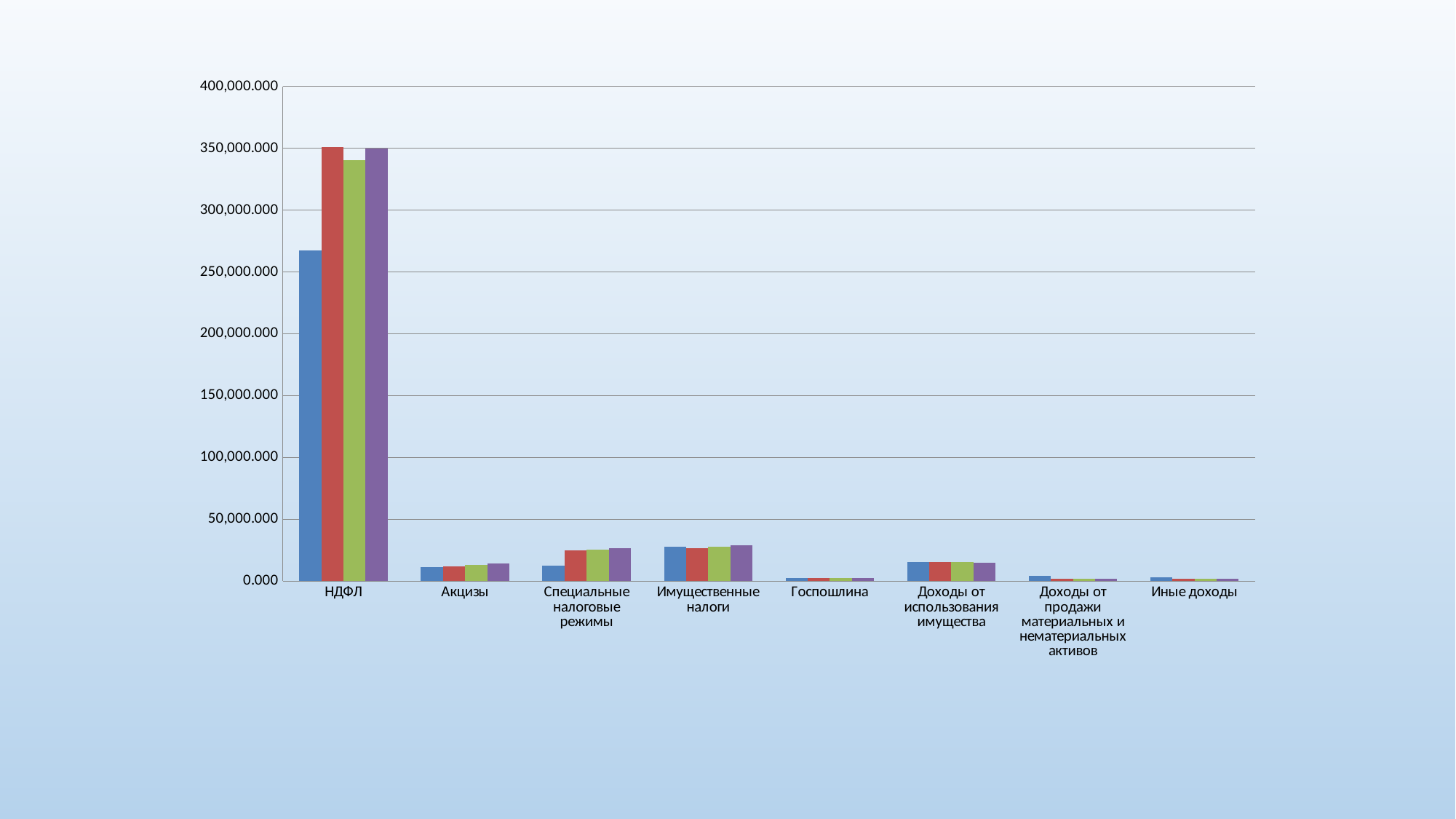
What is the highest value shown on the y axis of the chart? 400,000.000 Is the value of the red bar for НДФЛ greater or less than 300,000.000? greater Which category has higher values: Имущественные налоги or Акцизы? Имущественные налоги How many categories are shown along the x axis of the chart? 8 What kind of chart is shown on the slide? bar chart For НДФЛ, which bar is taller: the blue bar or the red bar? the red bar Is the value of the blue bar for НДФЛ greater or less than 250,000.000? greater Which category has the higher purple bar: Специальные налоговые режимы or Доходы от использования имущества? Специальные налоговые режимы How many bars are shown for each category in the chart? 4 Which category has the highest values in the chart? НДФЛ Are the values for Акцизы greater or less than 50,000.000? less